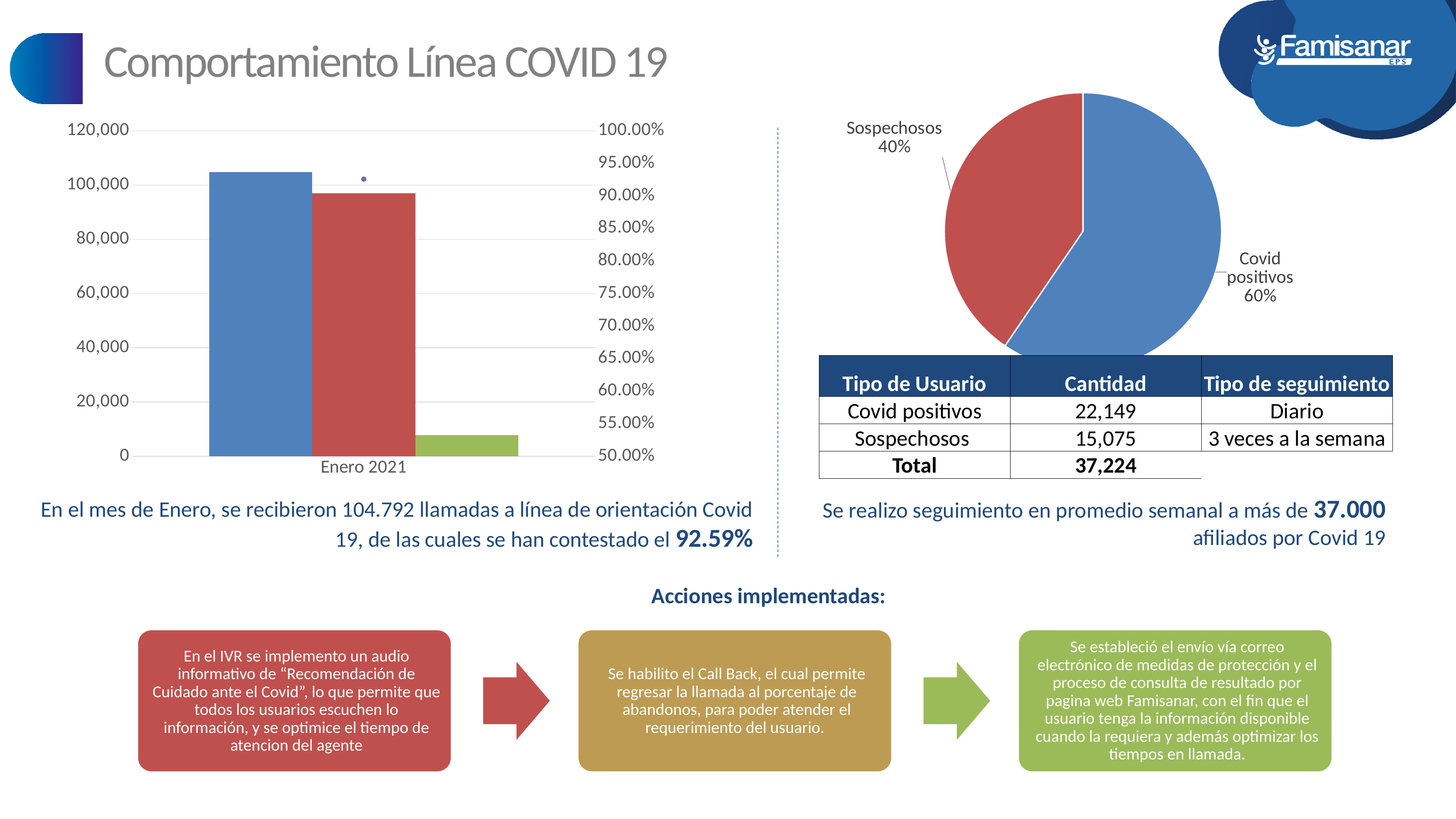
In the pie chart on the right, what share does Covid positivos have? 60% In the bar chart on the left, what is the only category label on the x axis? Enero 2021 In the pie chart on the right, how many slices are there? 2 In the pie chart on the right, which slice is the largest? Covid positivos In the pie chart on the right, which is larger, Covid positivos or Sospechosos? Covid positivos In the pie chart on the right, what share does Sospechosos have? 40% In the pie chart on the right, what is the difference in percentage points between Covid positivos and Sospechosos? 20% What kind of chart is the chart on the right of the slide? pie chart What kind of chart is the chart on the left of the slide? bar chart In the pie chart on the right, which slice is the smallest? Sospechosos In the bar chart on the left, is the value of the blue bar greater or less than 100,000? greater In the bar chart on the left, how many bars are plotted? 3